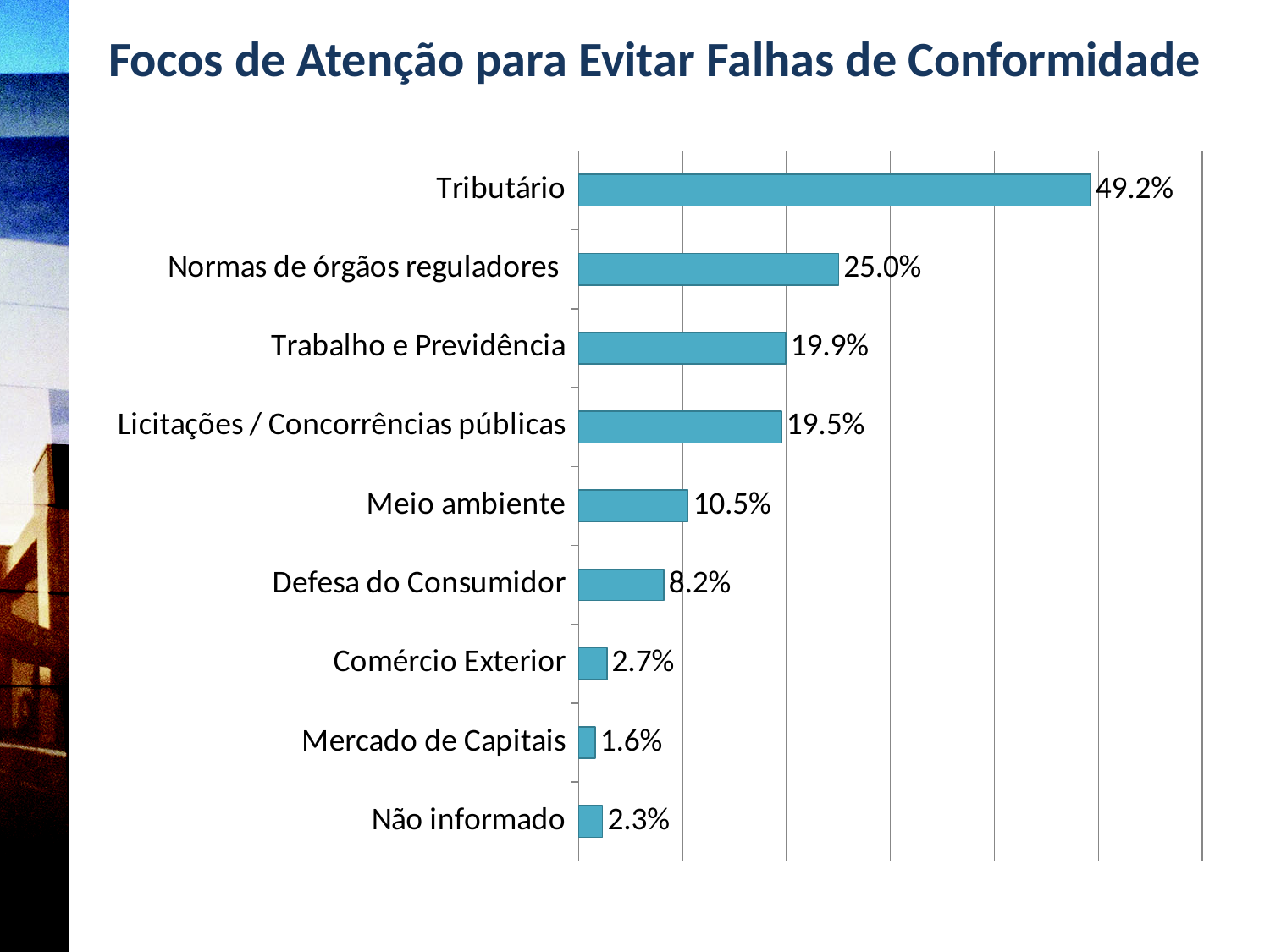
Which category has the highest value? Tributário What is the value for Mercado de Capitais? 1.6% What is the difference between the values for Trabalho e Previdência and Licitações / Concorrências públicas? 0.4% What is the difference between the values for Tributário and Normas de órgãos reguladores? 24.2% What is the value for Normas de órgãos reguladores? 25.0% Which is larger, the value for Defesa do Consumidor or the value for Comércio Exterior? Defesa do Consumidor How many categories are shown in the chart? 9 Which category has the lowest value? Mercado de Capitais What is the value for Tributário? 49.2% What is the title of the slide? Focos de Atenção para Evitar Falhas de Conformidade What is the value for Meio ambiente? 10.5% What kind of chart is shown on the slide? Bar chart